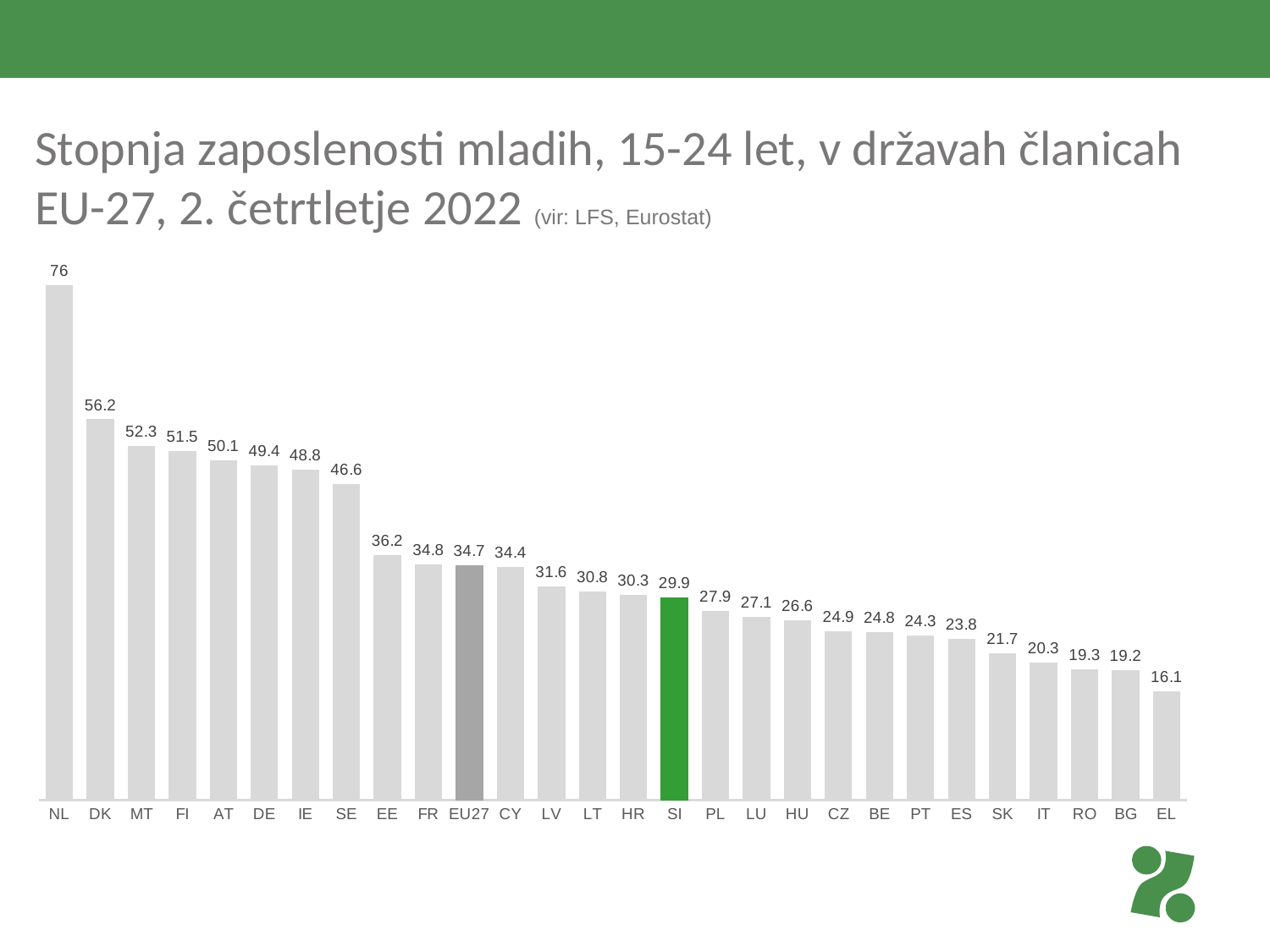
Which country has the lowest value? EL Which bar is coloured green? SI What is the value for NL? 76 Which has a larger value, SE or EE? SE What is the value for EU27? 34.7 What kind of chart is shown on the slide? Bar chart What is the value for SI? 29.9 Do the values rise or fall from left to right along the x axis? Fall What is the difference between the values for EU27 and SI? 4.8 What is the difference between the values for NL and DK? 19.8 Which country has the highest value? NL How many bars are shown in the chart? 28